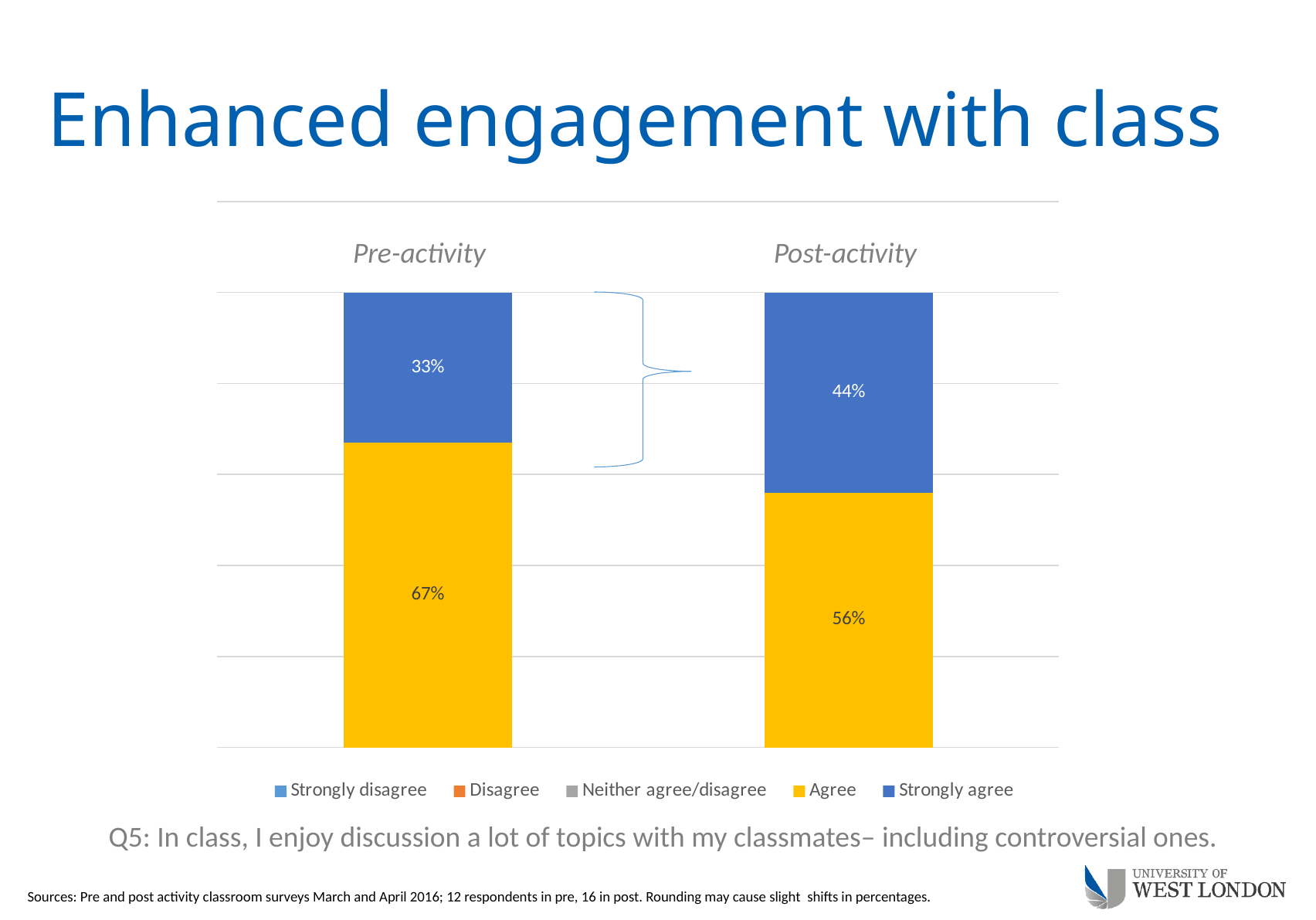
What percentage of Post-activity respondents selected Agree? 56% By how many percentage points did the Strongly agree share increase from Pre-activity to Post-activity? 11 percentage points Which has a larger Strongly agree share, Pre-activity or Post-activity? Post-activity How many series does the legend list? 5 Which legend entry is shown in yellow? Agree What percentage of Pre-activity respondents selected Strongly agree? 33% What percentage of Pre-activity respondents selected Agree? 67% Which has a larger Agree share, Pre-activity or Post-activity? Pre-activity What is the difference between the Agree share in Pre-activity and in Post-activity? 11 percentage points How many bars are shown in the chart? 2 What percentage of Post-activity respondents selected Strongly agree? 44% What kind of chart is shown on the slide? Stacked bar chart